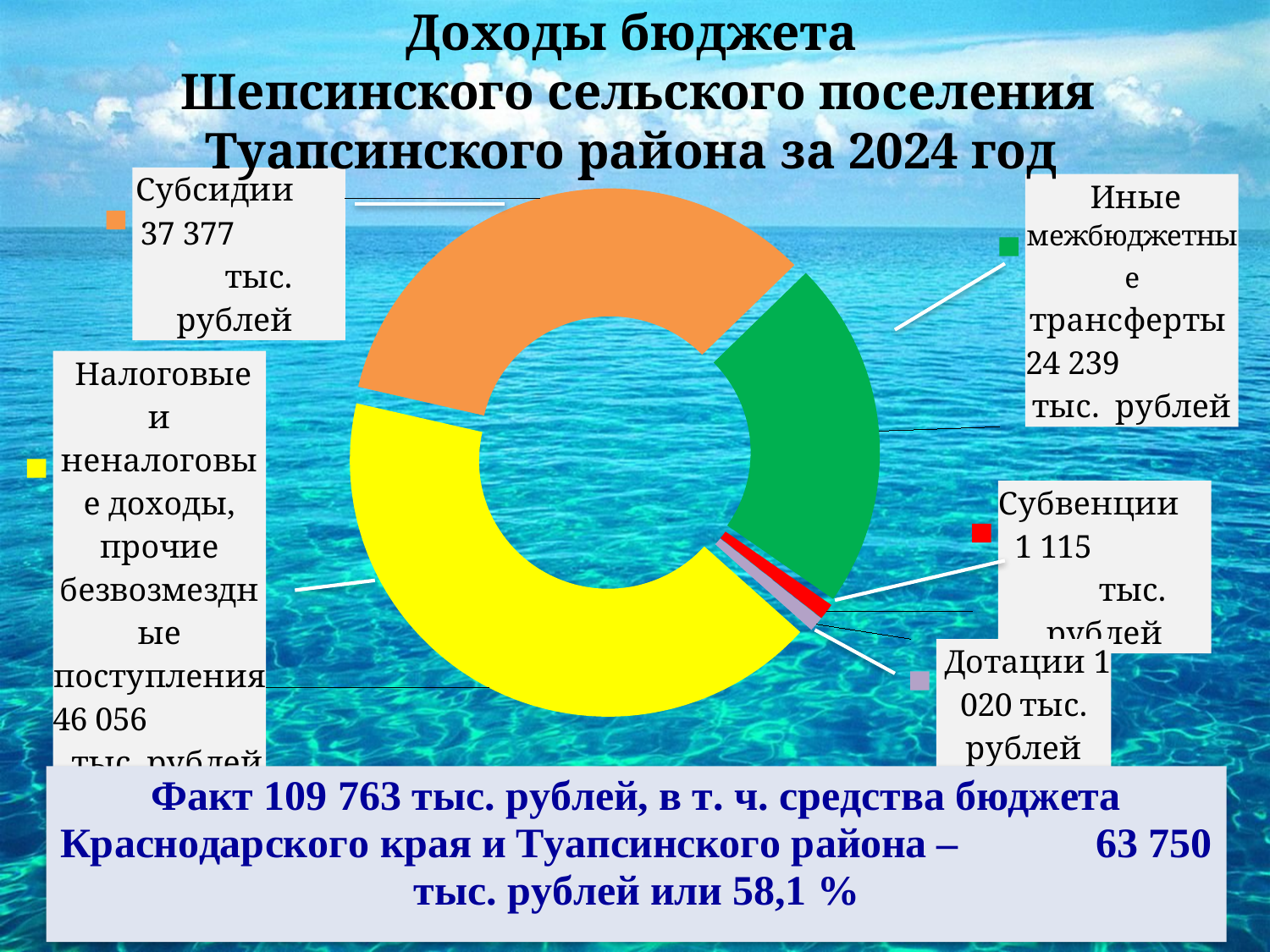
What is the difference between Налоговые и неналоговые доходы, прочие безвозмездные поступления and Субсидии? 8 679 тыс. рублей What is the value for Иные межбюджетные трансферты? 24 239 тыс. рублей Which is larger, Субвенции or Дотации? Субвенции What is the value for Налоговые и неналоговые доходы, прочие безвозмездные поступления? 46 056 тыс. рублей What is the value for Субсидии? 37 377 тыс. рублей Which category has the smallest value? Дотации What is the value for Дотации? 1 020 тыс. рублей Which category has the largest value? Налоговые и неналоговые доходы, прочие безвозмездные поступления What is the value for Субвенции? 1 115 тыс. рублей What kind of chart is shown on the slide? Doughnut (pie) chart How many categories does the chart show? 5 What colour is the segment for Иные межбюджетные трансферты? Green